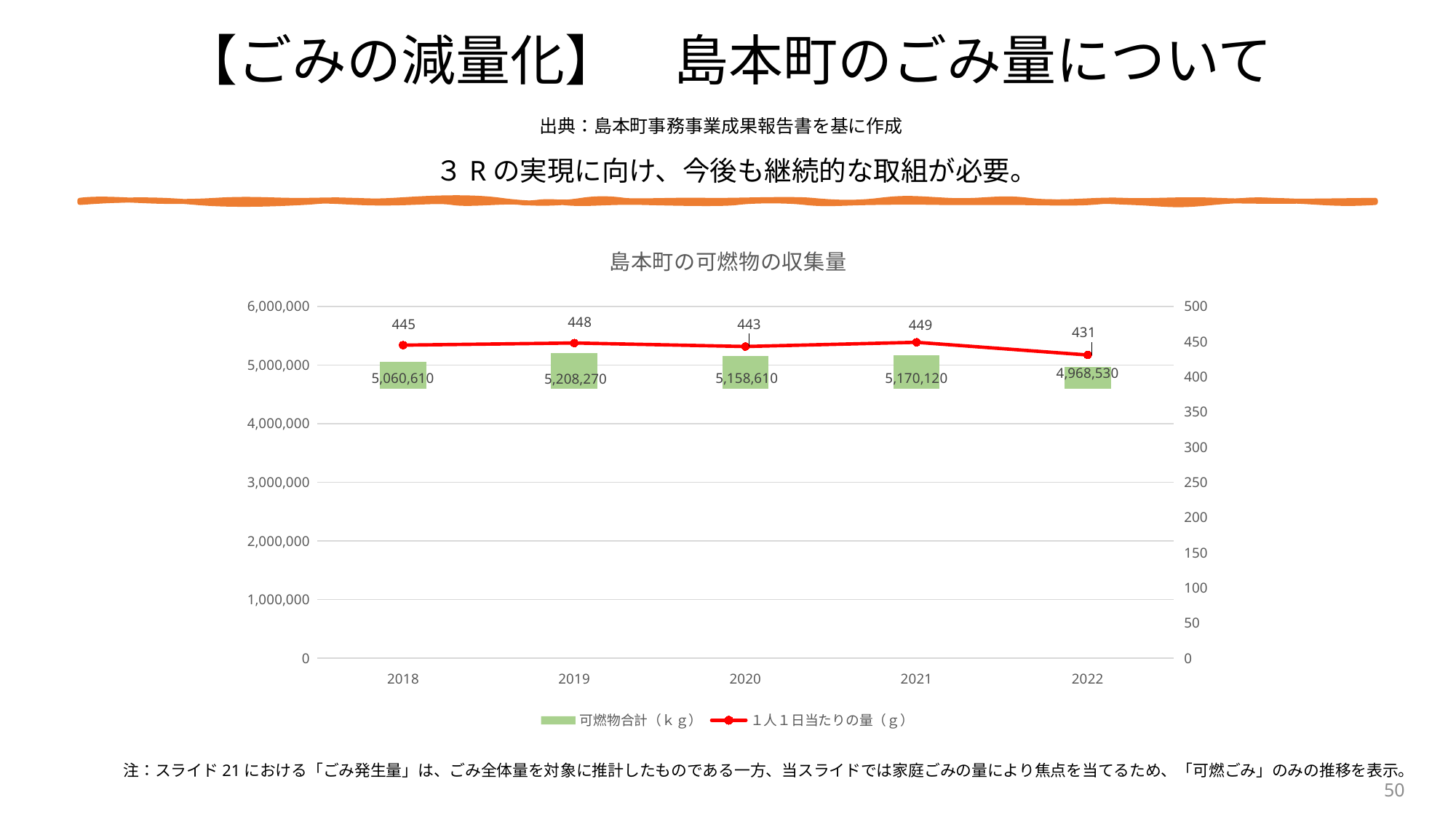
Which is larger, the 可燃物合計（kg） value for 2020 or for 2021? 2021 Which year has the lowest 可燃物合計（kg） value? 2022 What is the title of the chart? 島本町の可燃物の収集量 What is the difference between the 可燃物合計（kg） values for 2019 and 2022? 239,740 What is the 可燃物合計（kg） value for 2018? 5,060,610 What kind of chart is this? Combined bar and line chart Which year has the highest 1人1日当たりの量（g） value? 2021 How many years are shown on the x axis? 5 What is the difference between the 1人1日当たりの量（g） values for 2021 and 2022? 18 What is the 1人1日当たりの量（g） value for 2022? 431 What is the 可燃物合計（kg） value for 2019? 5,208,270 How many series does the legend list? 2